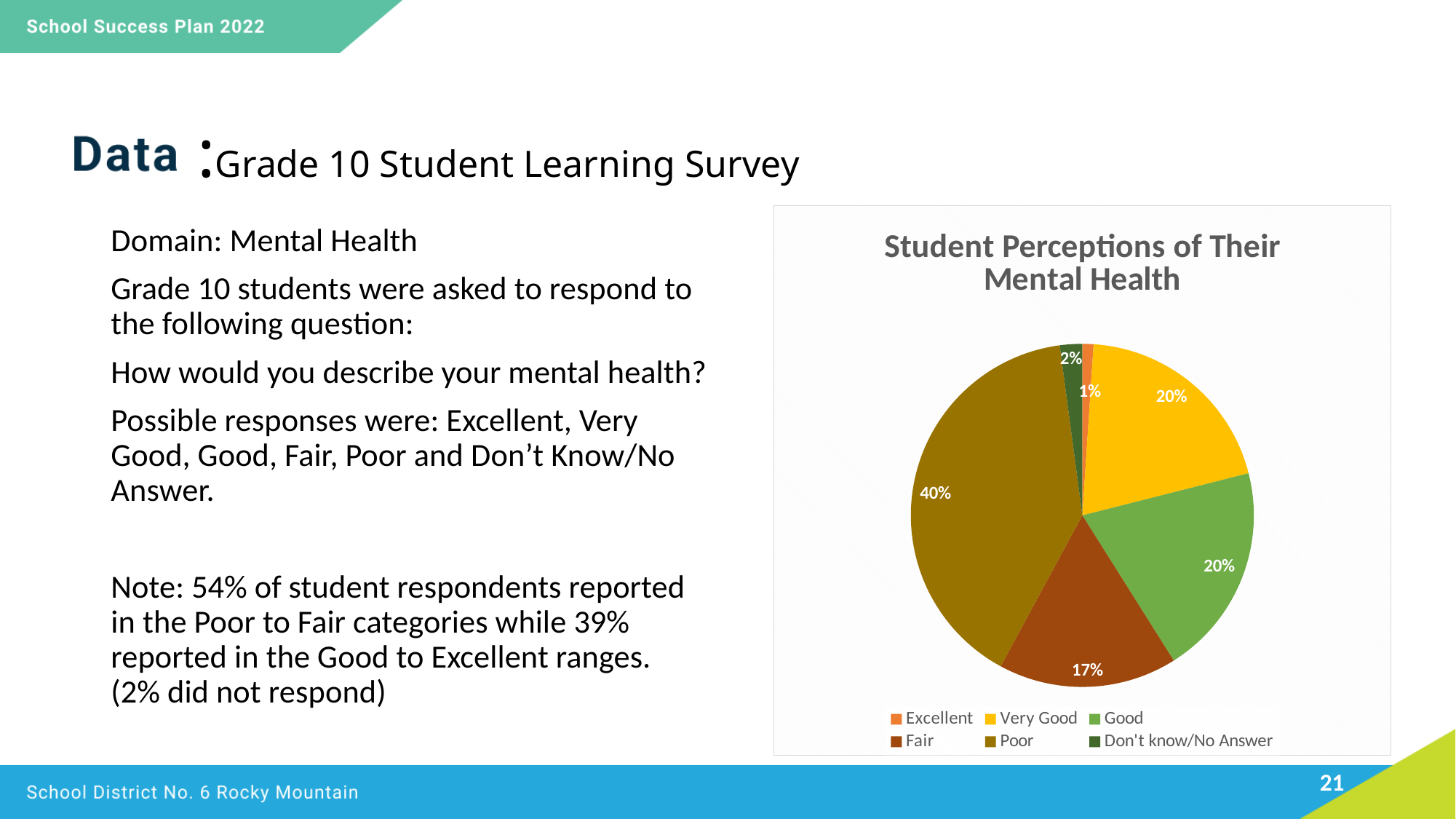
Which is larger, the Fair slice or the Good slice? Good How many categories does the legend list? 6 What is the combined percentage for Very Good and Good? 40% Which category has the smallest slice of the pie? Excellent What percentage of students rated their mental health as Excellent? 1% What is the title of the chart? Student Perceptions of Their Mental Health What percentage of students rated their mental health as Poor? 40% What share of the pie is Don't know/No Answer? 2% What type of chart is shown on the slide? pie chart Which category has the largest slice of the pie? Poor What percentage of students rated their mental health as Fair? 17% What is the difference between the Poor and Fair percentages? 23%